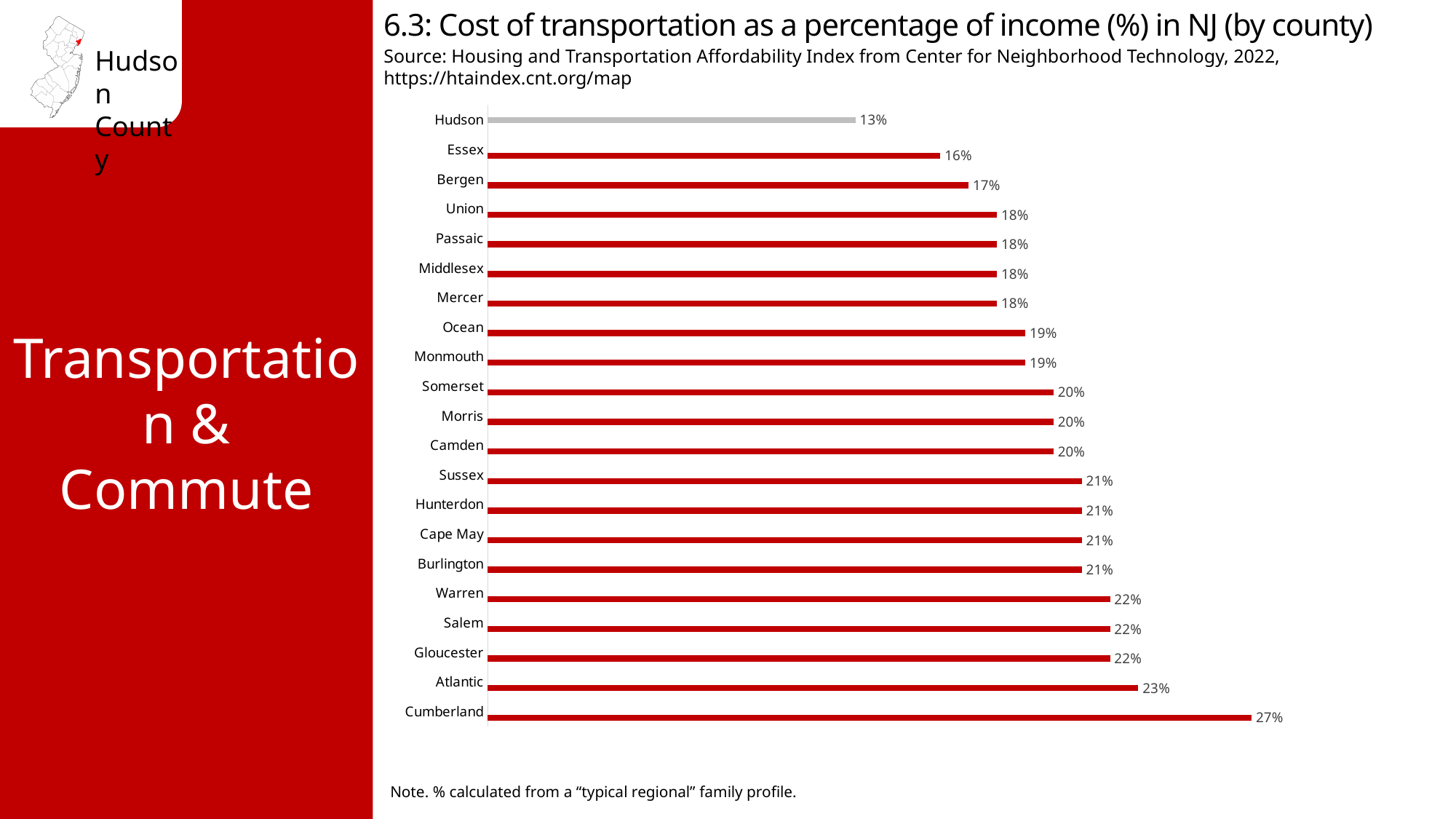
What is the difference between the values for Essex and Atlantic? 7% How many counties are shown in the chart? 21 What is the value shown for Cumberland County? 27% What is the value shown for Bergen County? 17% Which county has the highest cost of transportation as a percentage of income? Cumberland Which county's bar is shown in a different colour (grey) from the others? Hudson What is the difference between the values for Cumberland and Hudson? 14% What kind of chart is shown on the slide? Bar chart What is the value shown for Atlantic County? 23% What is the cost of transportation as a percentage of income for Hudson County? 13% Which county has the lowest cost of transportation as a percentage of income? Hudson Which has a higher value, Essex or Warren? Warren